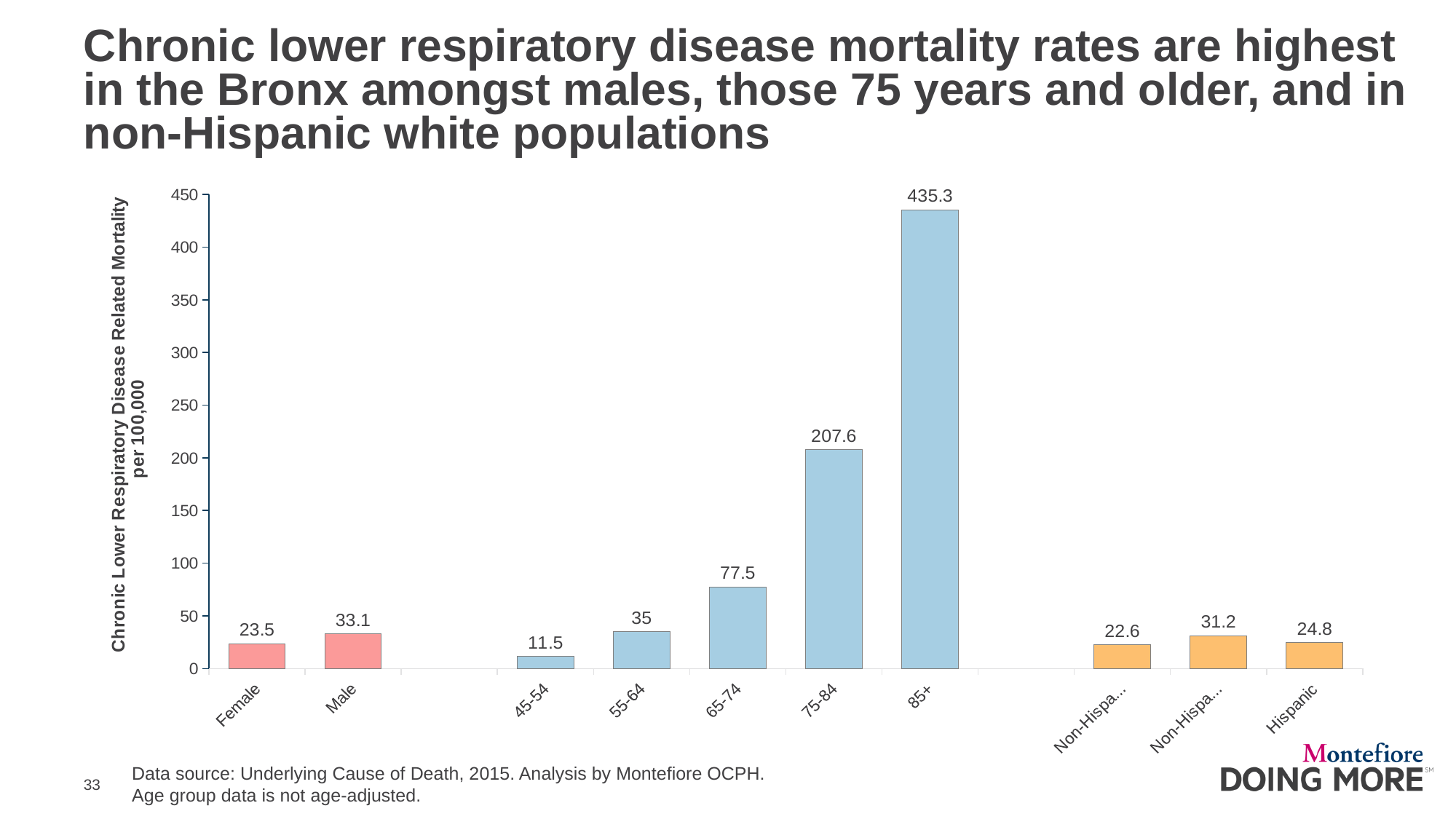
Which category has the highest mortality rate? 85+ How many bars are shown in the chart? 10 Is the mortality rate for the 65-74 age group greater or less than 100? less Which category has the lowest mortality rate? 45-54 Which has a higher mortality rate, males or females? Male What is the mortality rate for the Hispanic population? 24.8 What type of chart is shown on the slide? Bar chart What is the chronic lower respiratory disease mortality rate for females? 23.5 What is the difference in mortality rate between the 85+ and 75-84 age groups? 227.7 What is the mortality rate for the 85+ age group? 435.3 What is the chronic lower respiratory disease mortality rate for males? 33.1 What is the mortality rate for the 75-84 age group? 207.6